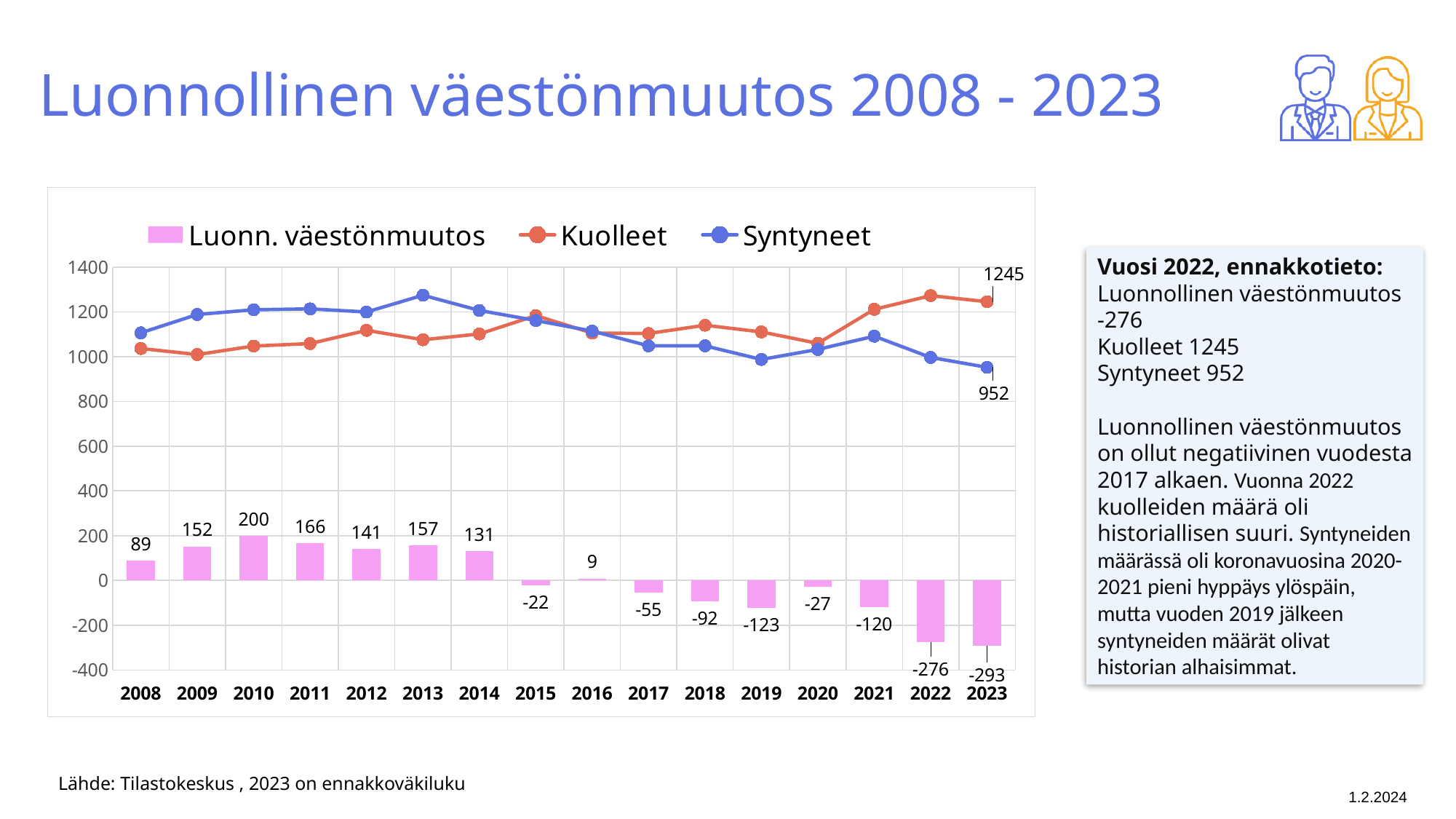
Which year has the lowest Luonn. väestönmuutos value? 2023 What is the value of Luonn. väestönmuutos for 2023? -293 Does the Luonn. väestönmuutos value rise or fall from 2021 to 2023? fall What is the value of Luonn. väestönmuutos for 2010? 200 Is the Syntyneet value for 2013 greater or less than 1200? greater What is the Syntyneet value shown for 2023? 952 What is the Kuolleet value shown for 2023? 1245 What is the difference between the Luonn. väestönmuutos values for 2009 and 2008? 63 Which year has the highest Luonn. väestönmuutos value? 2010 How many series does the legend list? 3 How many years are shown on the x axis? 16 Is the Luonn. väestönmuutos value for 2011 larger than the value for 2012? Yes, 166 is larger than 141